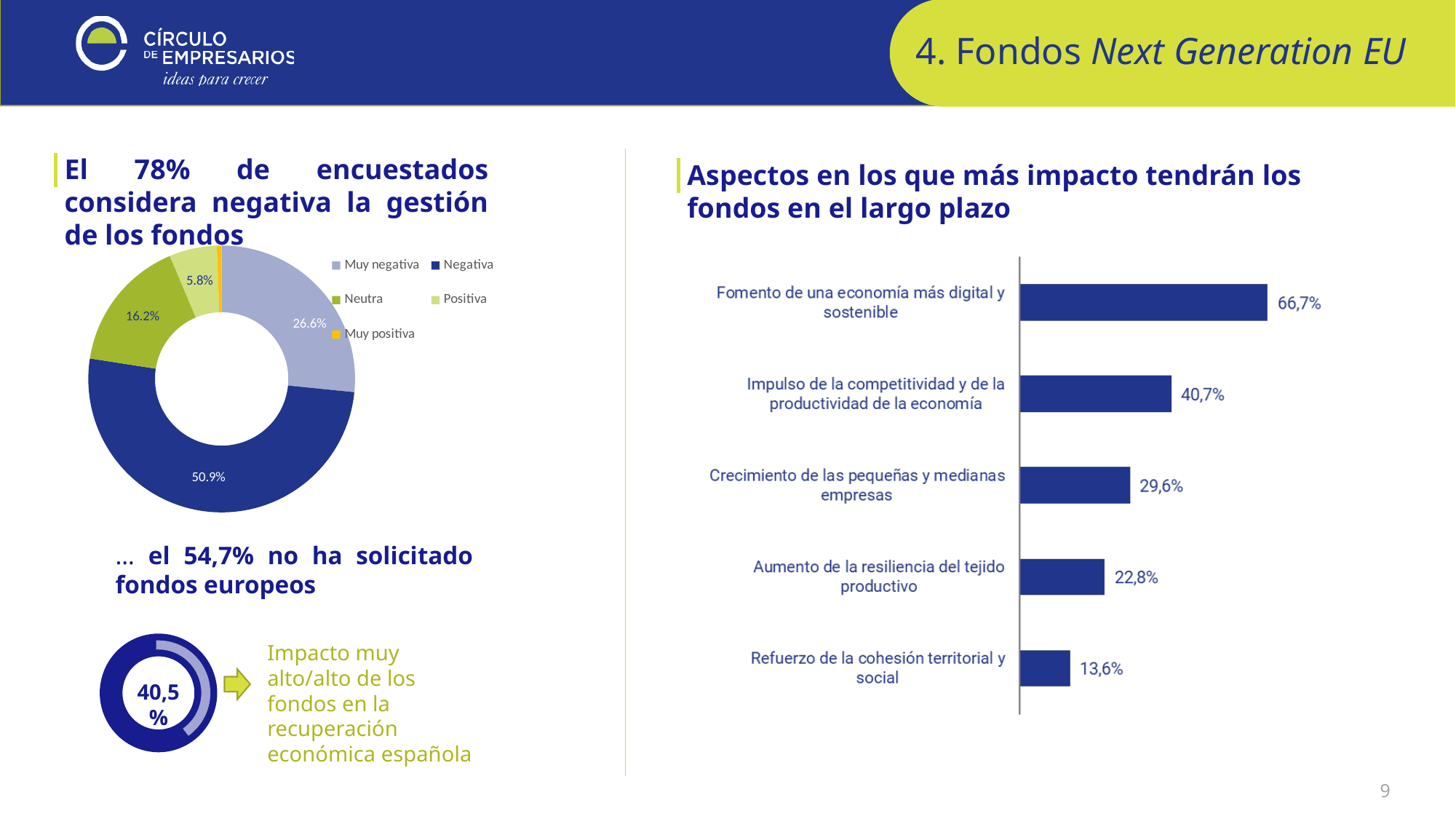
In the donut chart on the left, which is larger: 'Muy negativa' or 'Positiva'? Muy negativa In the bar chart on the right, what is the value for 'Refuerzo de la cohesión territorial y social'? 13,6% In the bar chart on the right, which category has the lowest value? Refuerzo de la cohesión territorial y social In the bar chart on the right, what is the value for 'Fomento de una economía más digital y sostenible'? 66,7% In the bar chart on the right, which category has the highest value? Fomento de una economía más digital y sostenible In the donut chart on the left, which category has the largest share? Negativa In the bar chart on the right, how many categories are shown? 5 How many entries does the legend of the donut chart on the left list? 5 What kind of chart is the chart on the right of the slide? Bar chart In the donut chart on the left, what share of respondents answered 'Neutra'? 16.2% In the donut chart on the left, what share of respondents answered 'Negativa'? 50.9% In the bar chart on the right, what is the difference between 'Impulso de la competitividad y de la productividad de la economía' and 'Crecimiento de las pequeñas y medianas empresas'? 11,1%